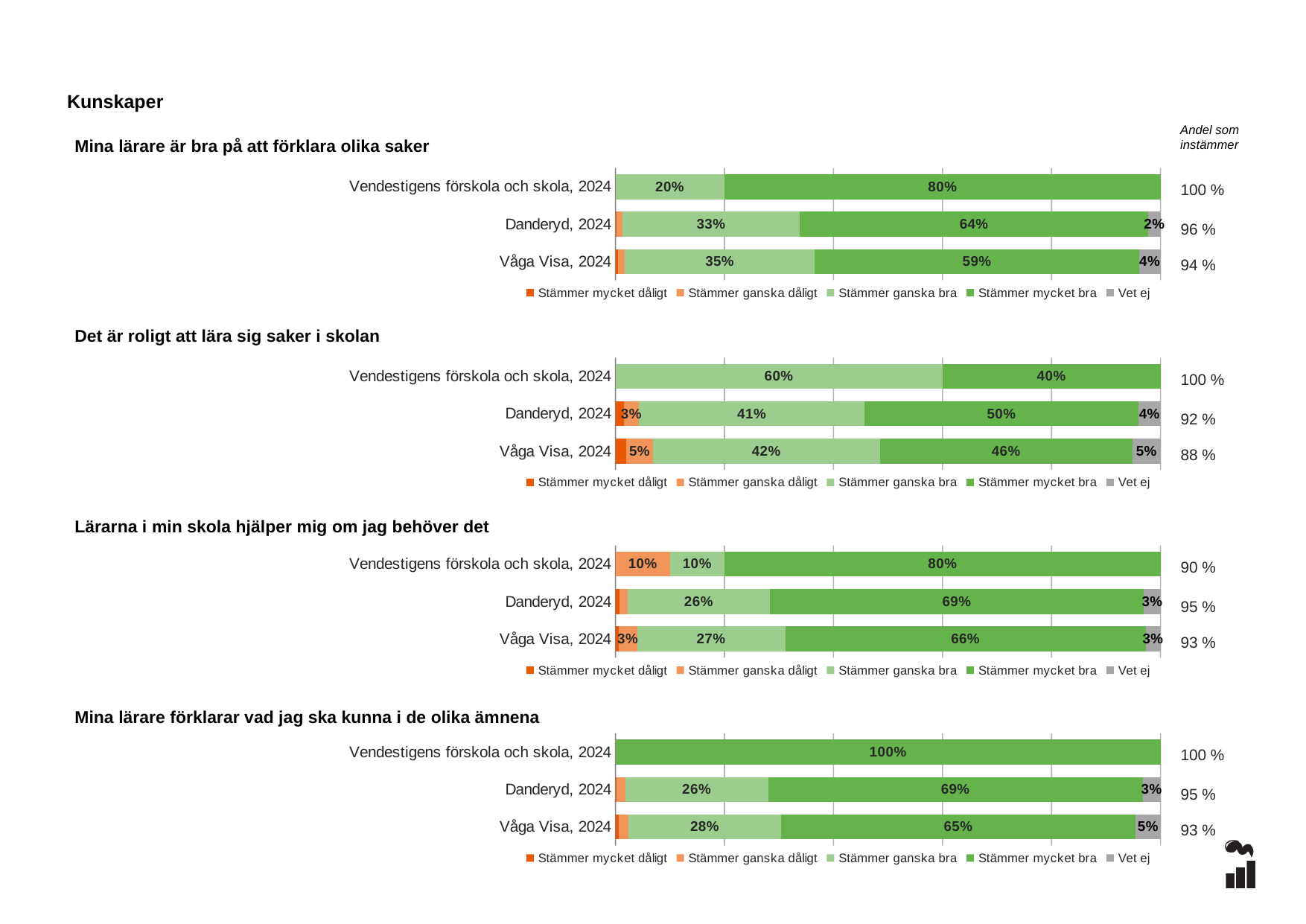
How many categories are shown in the chart "Mina lärare är bra på att förklara olika saker"? 3 In the chart "Mina lärare är bra på att förklara olika saker", what is the "Stämmer mycket bra" value for Vendestigens förskola och skola, 2024? 80% In the chart "Det är roligt att lära sig saker i skolan", what is the "Vet ej" value for Våga Visa, 2024? 5% What kind of chart is "Lärarna i min skola hjälper mig om jag behöver det"? Stacked bar chart In the chart "Mina lärare förklarar vad jag ska kunna i de olika ämnena", which is larger: the "Stämmer ganska bra" value for Danderyd, 2024 or for Våga Visa, 2024? Våga Visa, 2024 In the chart "Lärarna i min skola hjälper mig om jag behöver det", what is the difference between the "Stämmer mycket bra" values for Danderyd, 2024 and Våga Visa, 2024? 3% In the chart "Det är roligt att lära sig saker i skolan", what is the "Stämmer ganska bra" value for Vendestigens förskola och skola, 2024? 60% In the chart "Det är roligt att lära sig saker i skolan", which category has the highest "Stämmer mycket bra" value? Danderyd, 2024 In the chart "Mina lärare förklarar vad jag ska kunna i de olika ämnena", what is the "Stämmer mycket bra" value for Vendestigens förskola och skola, 2024? 100% How many series does the legend of the chart "Det är roligt att lära sig saker i skolan" list? 5 In the chart "Lärarna i min skola hjälper mig om jag behöver det", what is the "Stämmer ganska dåligt" value for Vendestigens förskola och skola, 2024? 10% In the chart "Mina lärare är bra på att förklara olika saker", what is the "Stämmer ganska bra" value for Våga Visa, 2024? 35%